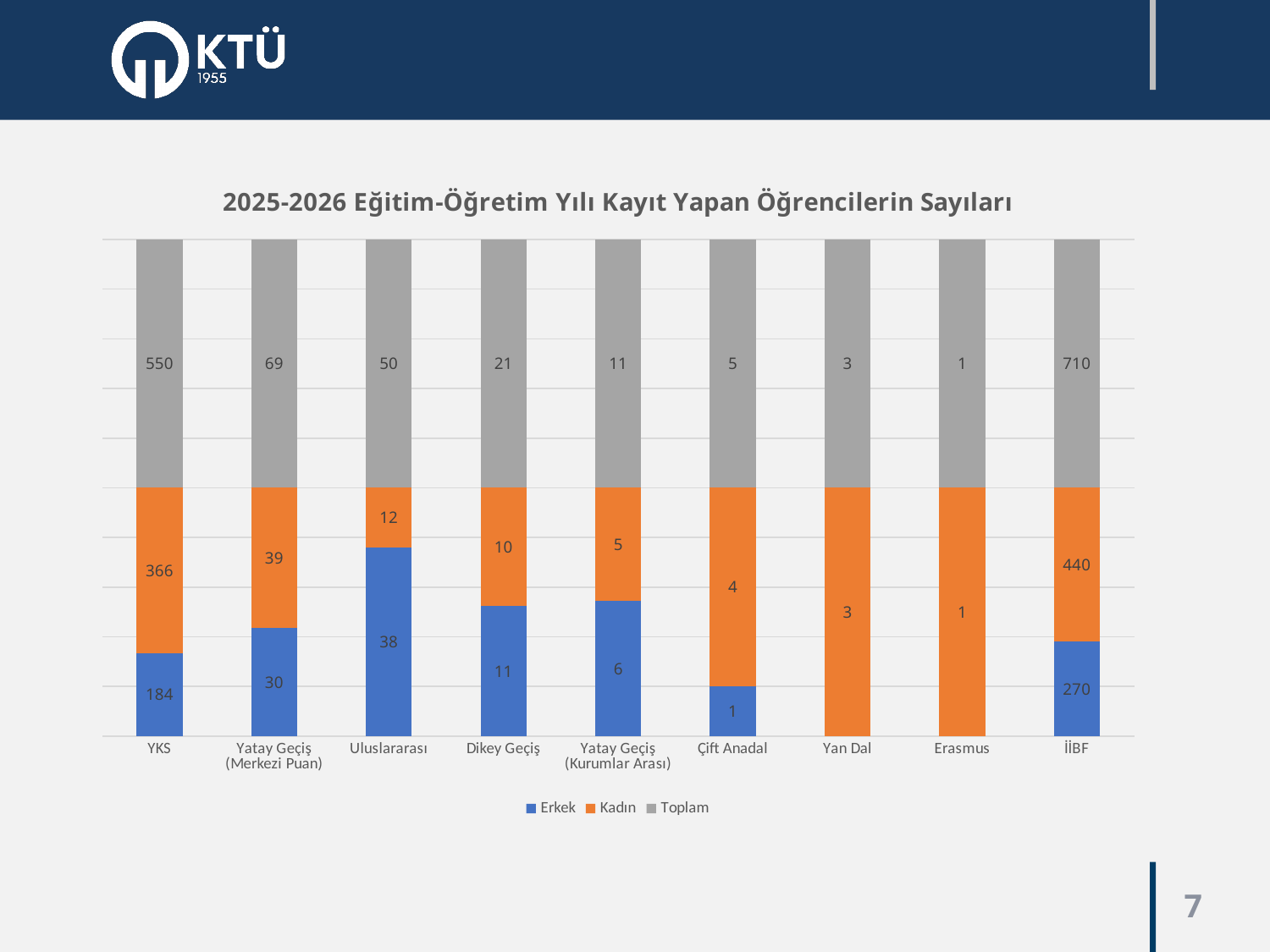
What is the Kadın value for Yatay Geçiş (Merkezi Puan)? 39 What is the difference between the Kadın and Erkek values for YKS? 182 What is the Kadın value for İİBF? 440 Which is larger for Uluslararası, the Erkek value or the Kadın value? Erkek What kind of chart is shown on the slide? Stacked bar chart How many series does the legend list? 3 What is the title of the chart? 2025-2026 Eğitim-Öğretim Yılı Kayıt Yapan Öğrencilerin Sayıları Which category has the lowest Toplam value? Erasmus How many categories are shown on the x axis? 9 What is the Toplam value for Uluslararası? 50 Which category has the highest Toplam value? İİBF What is the Erkek value for YKS? 184